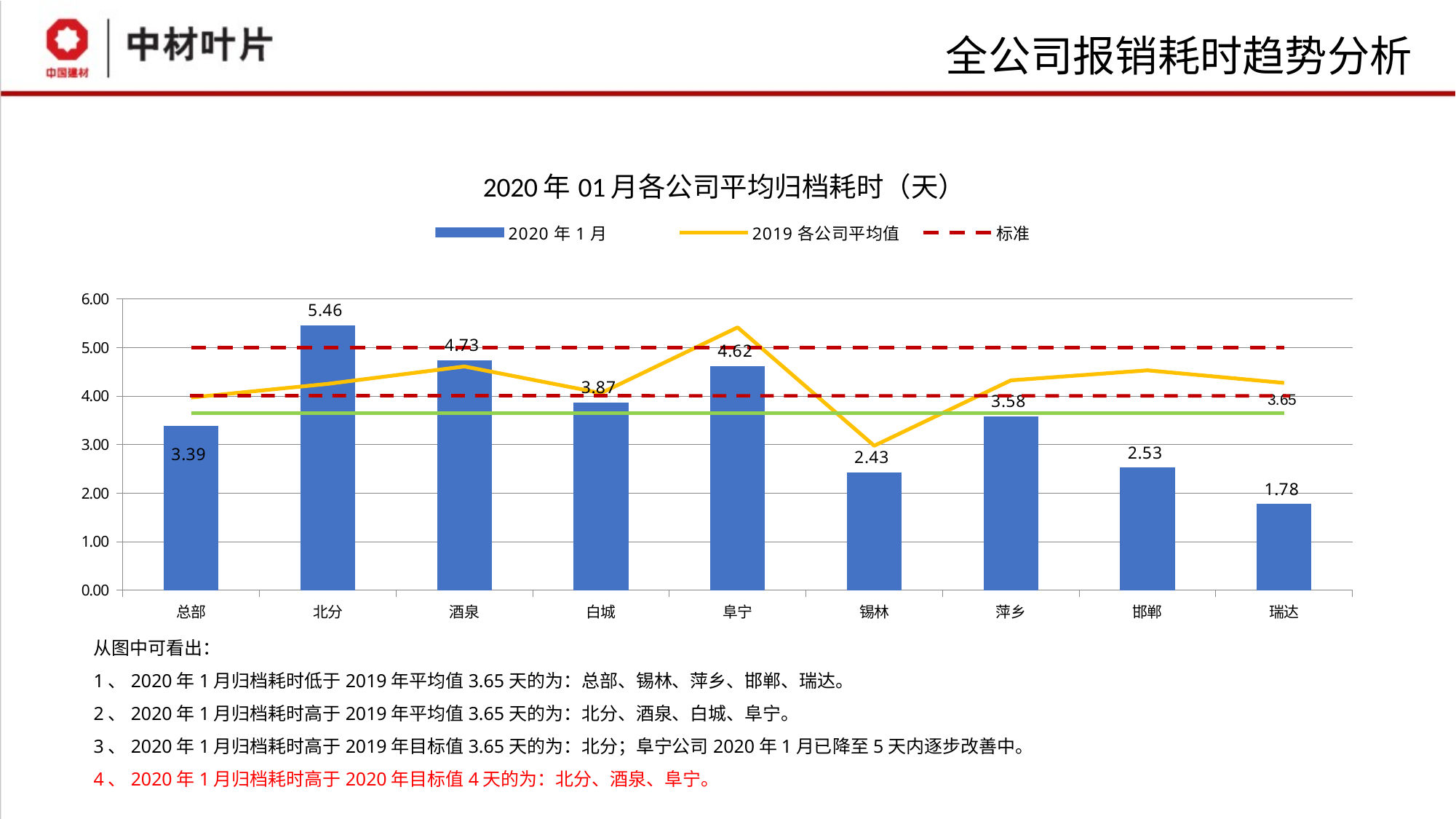
Is the 2020年1月 value for 邯郸 greater or less than 3.00? less How many companies are shown on the x axis? 9 Which company has the lowest 2020年1月 bar? 瑞达 What is the 2020年1月 value for 北分? 5.46 What is the 2020年1月 value for 锡林? 2.43 What is the difference between the 2020年1月 values for 北分 and 瑞达? 3.68 Which has a larger 2020年1月 value, 酒泉 or 阜宁? 酒泉 Which company has the highest 2020年1月 bar? 北分 What is the 2020年1月 value for 瑞达? 1.78 How many series does the legend list? 3 What kind of chart is used for the 2020年1月 series? bar chart What is the title of the chart? 2020年01月各公司平均归档耗时（天）